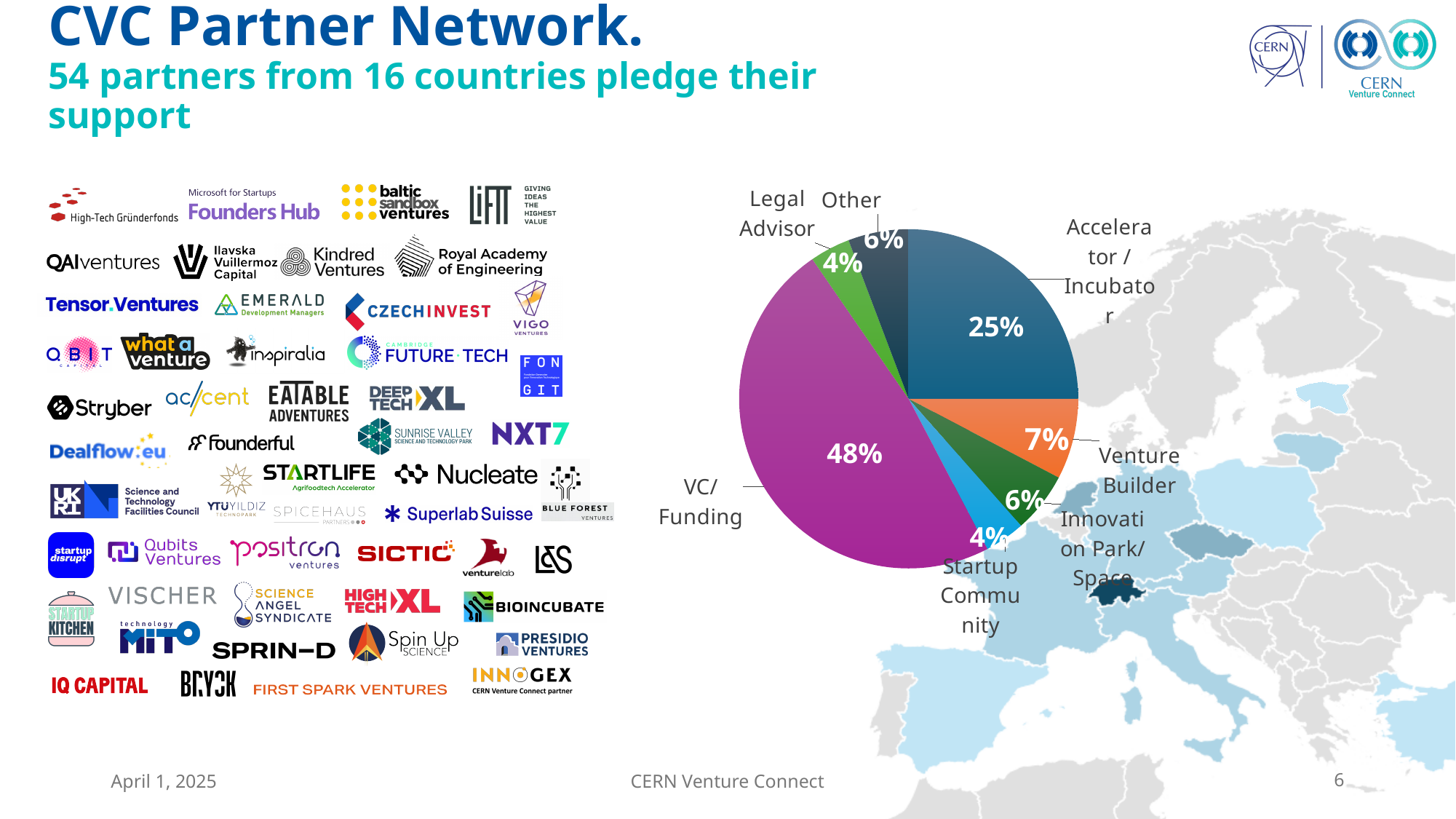
What colour is the VC/Funding slice of the pie chart? purple What is the combined share of Startup Community and Legal Advisor? 8% What type of chart is shown on the slide? pie chart What share of the pie chart does Legal Advisor represent? 4% What share of the pie chart does VC/Funding represent? 48% Which category has the largest slice of the pie chart? VC/Funding What is the difference in percentage points between VC/Funding and Accelerator / Incubator? 23 What share of the pie chart does Accelerator / Incubator represent? 25% How many categories are shown in the pie chart? 7 What share of the pie chart does Venture Builder represent? 7% Which is larger in the pie chart, Accelerator / Incubator or Venture Builder? Accelerator / Incubator What share of the pie chart does Innovation Park/Space represent? 6%